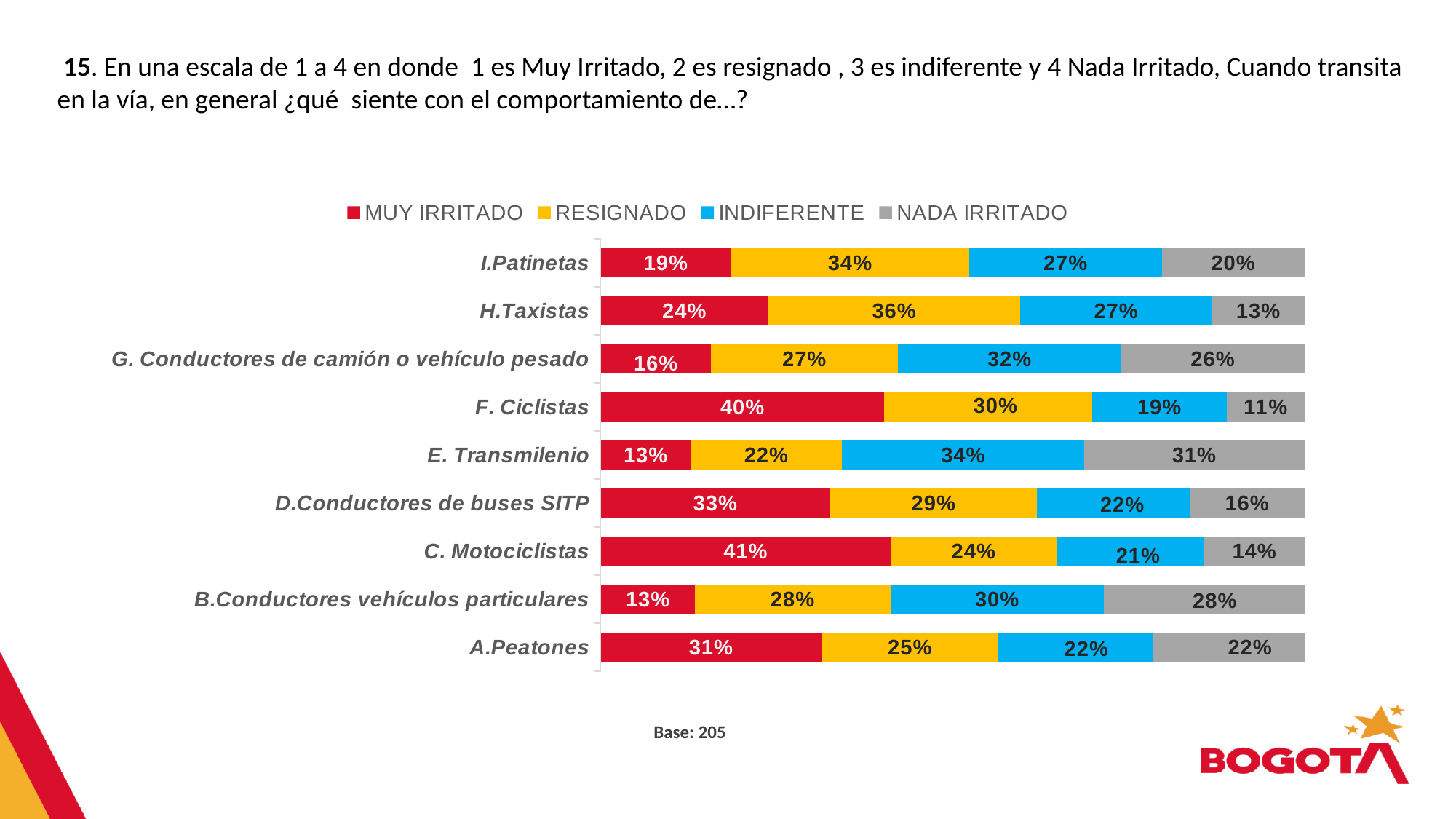
Which category has the lowest NADA IRRITADO value? F. Ciclistas How many series does the legend list? 4 What is the NADA IRRITADO value for E. Transmilenio? 31% Which is larger: the RESIGNADO value for I.Patinetas or for A.Peatones? I.Patinetas What is the difference between the MUY IRRITADO values for F. Ciclistas and E. Transmilenio? 27% What is the INDIFERENTE value for G. Conductores de camión o vehículo pesado? 32% Which colour represents the INDIFERENTE series? Blue What is the RESIGNADO value for H.Taxistas? 36% Which category has the highest MUY IRRITADO value? C. Motociclistas How many categories are shown on the chart? 9 What is the MUY IRRITADO value for C. Motociclistas? 41% What kind of chart is shown on the slide? Stacked bar chart